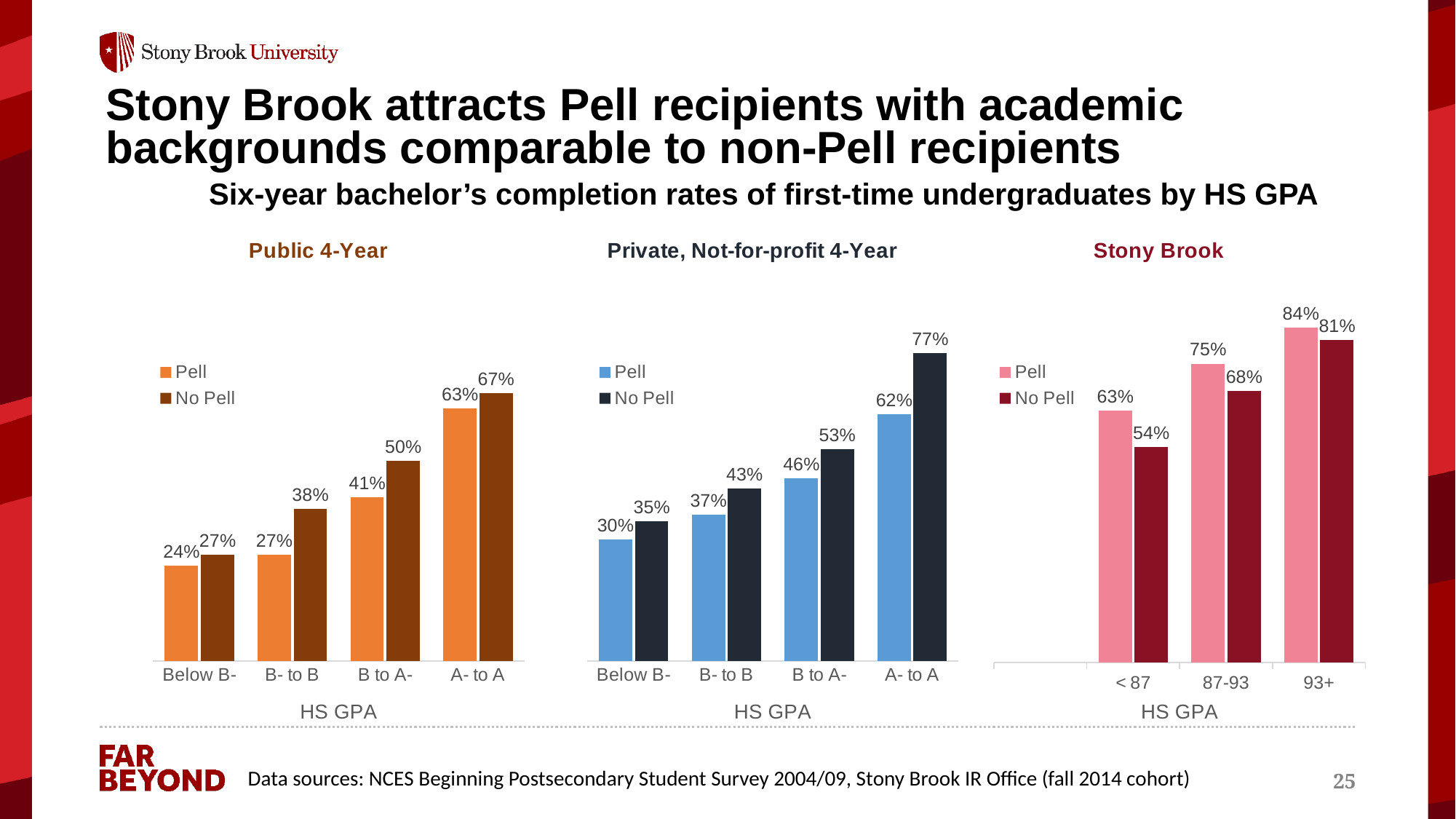
In the Public 4-Year chart, which HS GPA category has the lowest completion rate for Pell recipients? Below B- In the Private, Not-for-profit 4-Year chart, what is the difference between the No Pell and Pell completion rates for the A- to A category? 15% In the Public 4-Year chart, which is larger for the B- to B category: the Pell rate or the No Pell rate? No Pell In the Stony Brook chart, which HS GPA category has the highest completion rate for Pell recipients? 93+ How many series does the legend of the Public 4-Year chart list? 2 In the Public 4-Year chart, what is the completion rate for Pell recipients with a HS GPA of B to A-? 41% How many HS GPA categories are shown in the Stony Brook chart? 3 In the Stony Brook chart, which is larger for the 93+ category: the Pell rate or the No Pell rate? Pell In the Private, Not-for-profit 4-Year chart, do the Pell completion rates rise or fall as HS GPA increases from Below B- to A- to A? rise In the Stony Brook chart, what is the completion rate for Pell recipients with a HS GPA of 87-93? 75% In the Stony Brook chart, what is the difference between the Pell and No Pell completion rates for the < 87 HS GPA category? 9% In the Private, Not-for-profit 4-Year chart, what is the completion rate for No Pell students with a HS GPA of A- to A? 77%